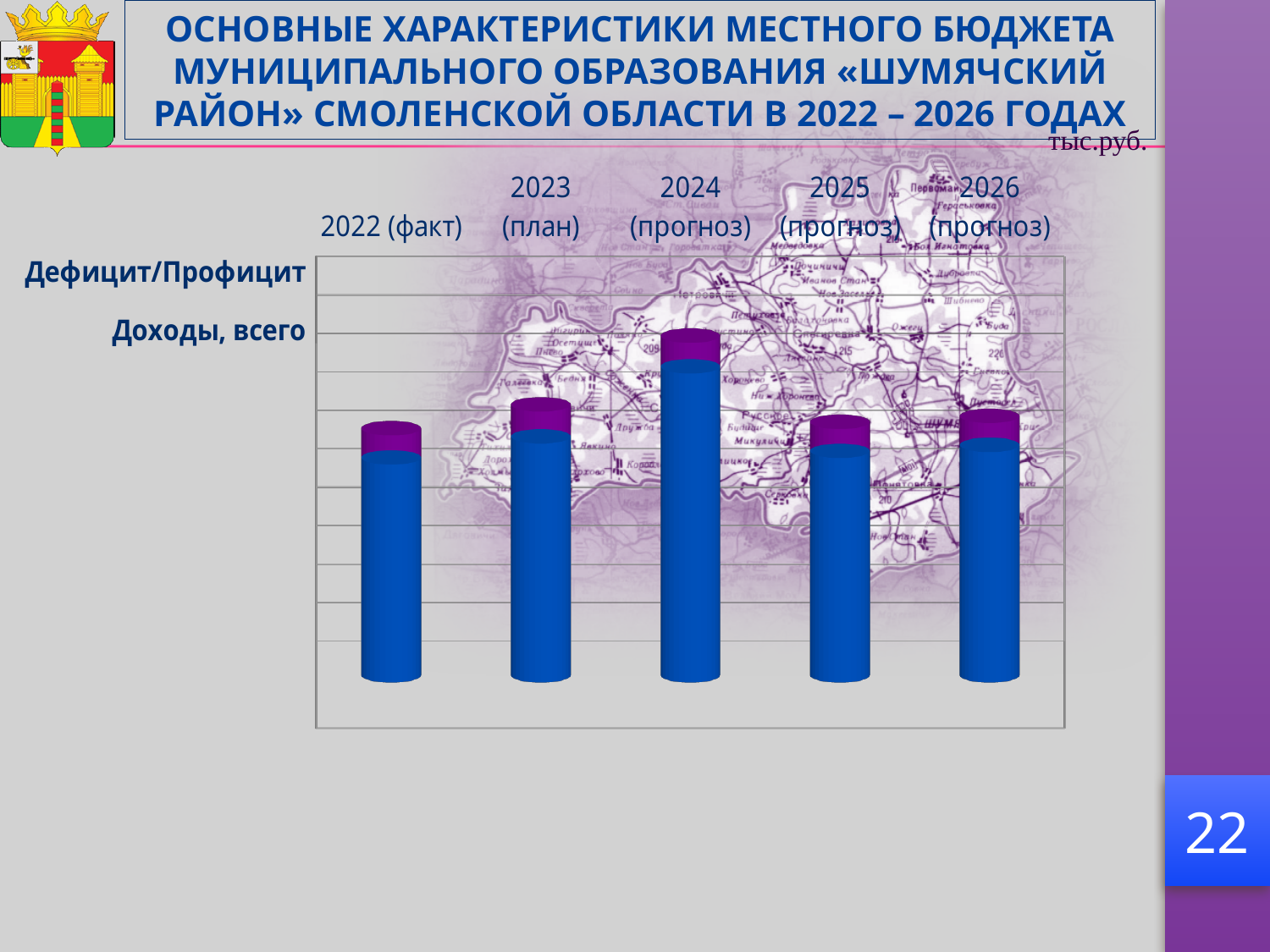
Which bar is taller, 2023 (план) or 2022 (факт)? 2023 (план) What kind of chart is shown on the slide? bar chart Do the bar heights rise or fall from 2022 (факт) to 2024 (прогноз)? rise Which bar is taller, 2024 (прогноз) or 2025 (прогноз)? 2024 (прогноз) What unit of measurement is indicated for the chart? тыс.руб. Which bar is taller, 2024 (прогноз) or 2022 (факт)? 2024 (прогноз) How many year categories are plotted along the x axis of the chart? 5 Which year has the tallest bar in the chart? 2024 (прогноз) Do the bar heights rise or fall from 2024 (прогноз) to 2025 (прогноз)? fall